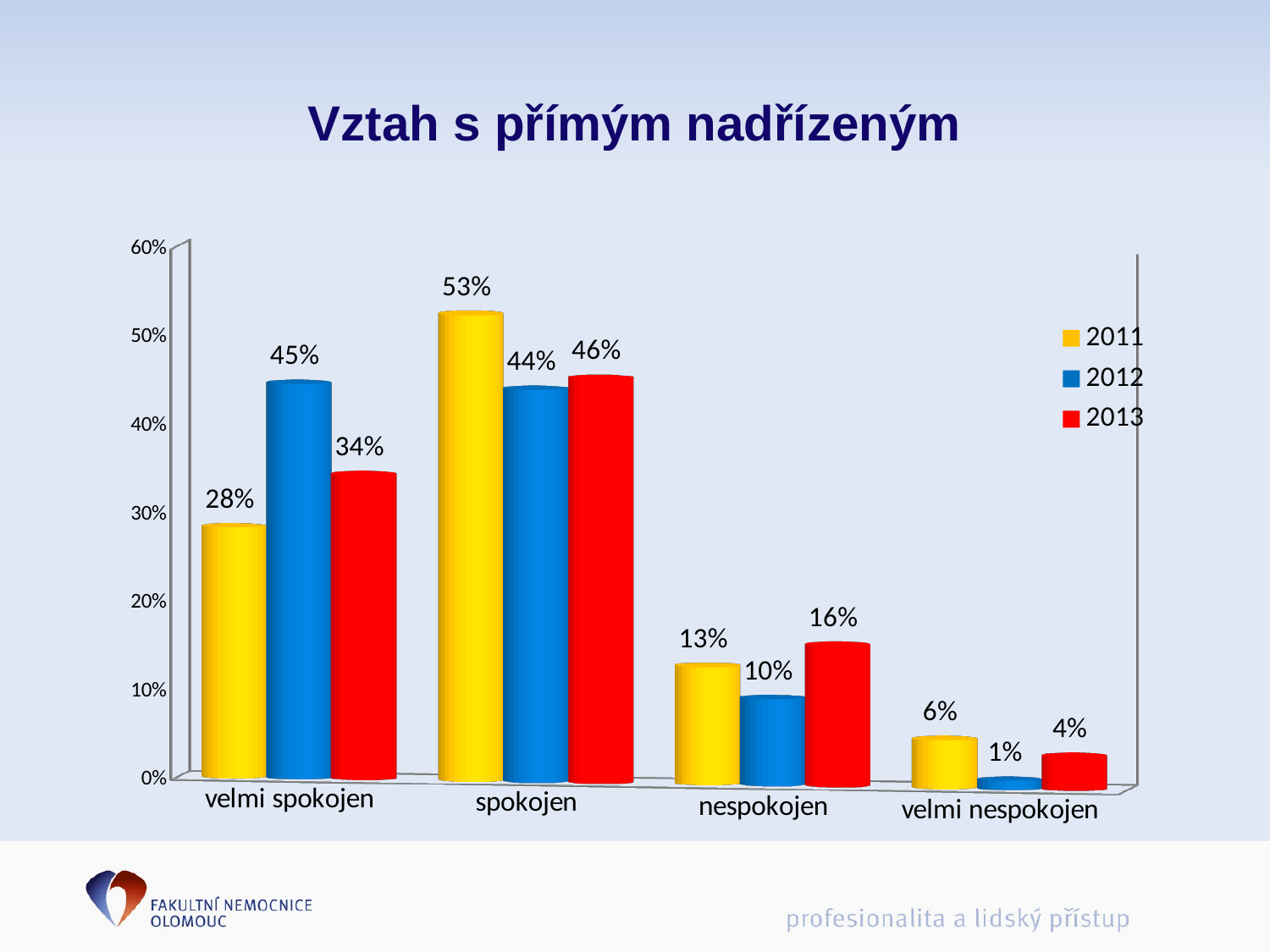
What is the value for 2012 in the 'velmi nespokojen' category? 1% What is the value for 2013 in the 'nespokojen' category? 16% Which is larger in the 'spokojen' category: the 2011 value or the 2012 value? 2011 How many categories are shown on the x axis? 4 Which category has the highest value for the 2011 series? spokojen How many series does the legend list? 3 What kind of chart is shown on the slide? bar chart Which category has the lowest value for the 2013 series? velmi nespokojen What is the value for 2011 in the 'velmi spokojen' category? 28% Which colour represents the 2013 series? red What is the title of the slide? Vztah s přímým nadřízeným What is the difference between the 2012 and 2013 values in the 'velmi spokojen' category? 11%